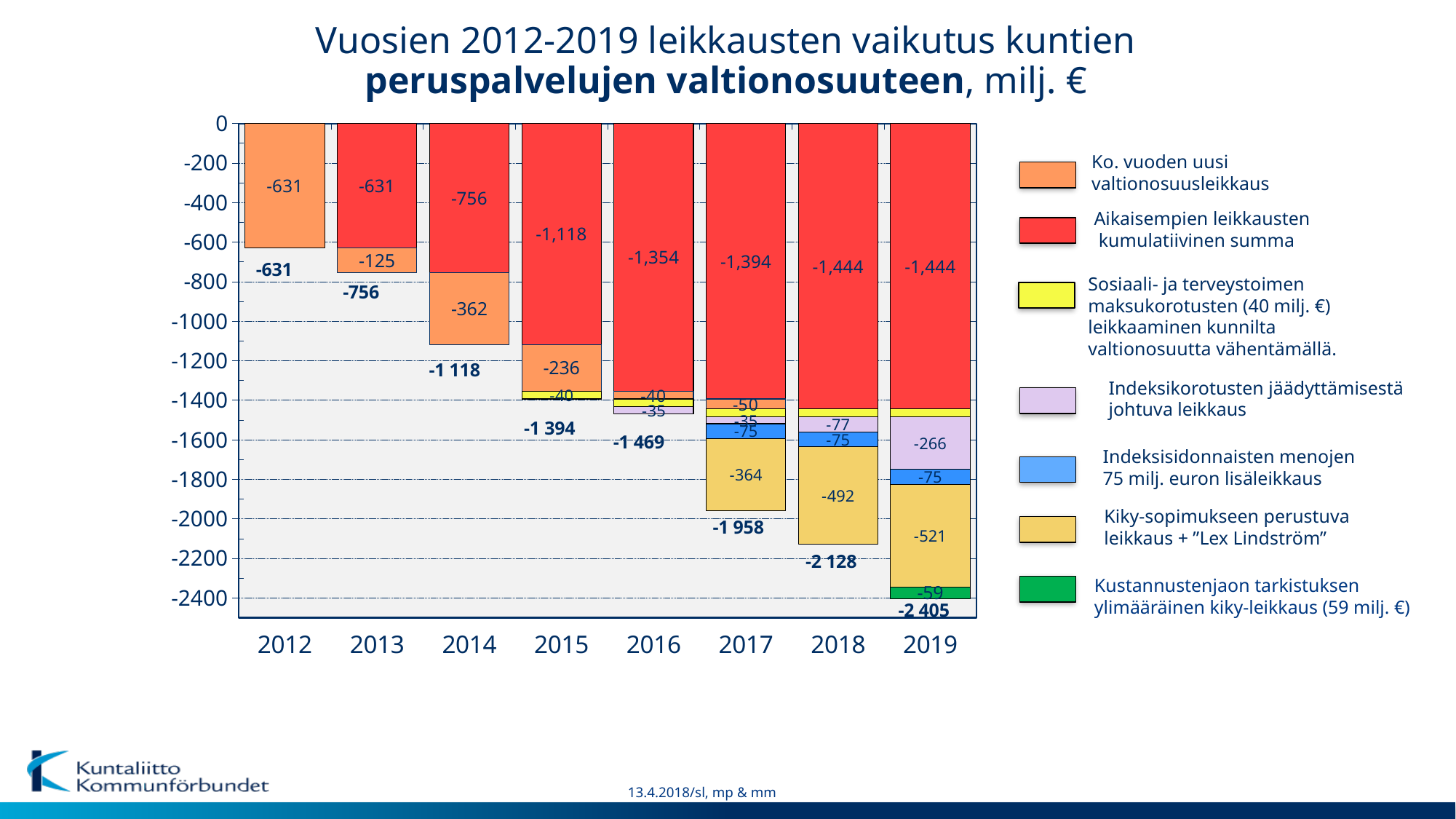
How do the bar totals change from 2012 to 2019? They become more negative each year Which year has the smallest total cut (the least negative bar total)? 2012 How many years are shown on the x axis of the chart? 8 By how much does the total for 2019 exceed the total for 2018 in magnitude? 277 What kind of chart is shown on the slide? Stacked bar chart Is the Kiky-sopimukseen perustuva leikkaus segment larger in magnitude in 2018 or in 2019? 2019 What is the value of the Ko. vuoden uusi valtionosuusleikkaus segment in 2014? -362 How many series does the legend list? 7 What is the value of the Kustannustenjaon tarkistuksen ylimääräinen kiky-leikkaus segment in 2019? -59 Which year has the largest total cut (the most negative bar total)? 2019 What is the value of the Kiky-sopimukseen perustuva leikkaus + "Lex Lindström" segment in 2018? -492 What is the total value printed below the bar for 2019? -2 405